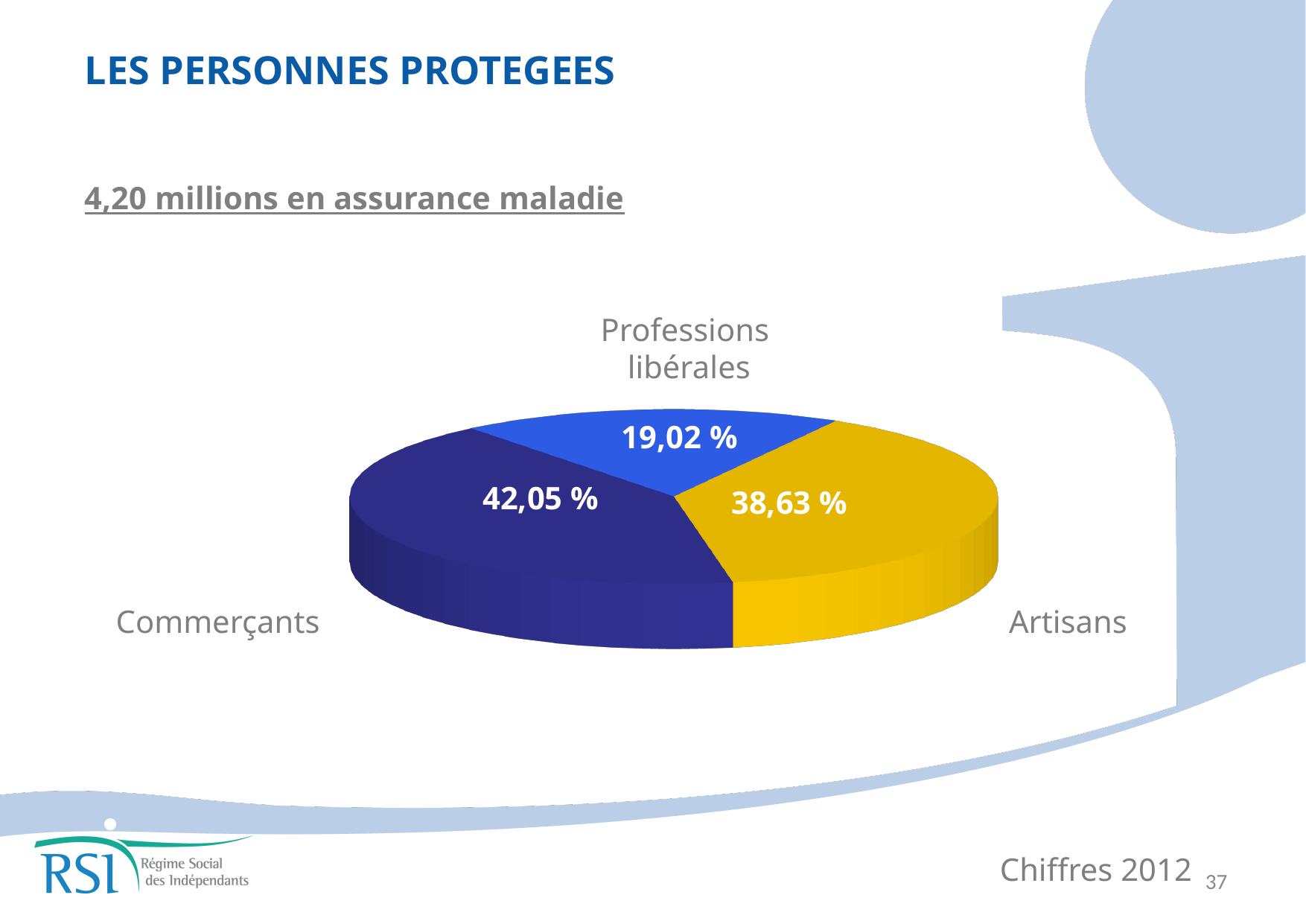
What colour is the Artisans slice of the pie chart? Yellow Which category has the smallest slice of the pie chart? Professions libérales What type of chart is shown on the slide? Pie chart What share of the pie chart is labelled for Professions libérales? 19,02 % Which category has the largest slice of the pie chart? Commerçants What is the underlined heading above the pie chart? 4,20 millions en assurance maladie How many categories are shown in the pie chart? 3 Which slice is larger, Artisans or Professions libérales? Artisans What share of the pie chart is labelled for Artisans? 38,63 % What is the difference in percentage points between the Commerçants slice and the Artisans slice? 3,42 What share of the pie chart is labelled for Commerçants? 42,05 % What is the difference in percentage points between the Artisans slice and the Professions libérales slice? 19,61